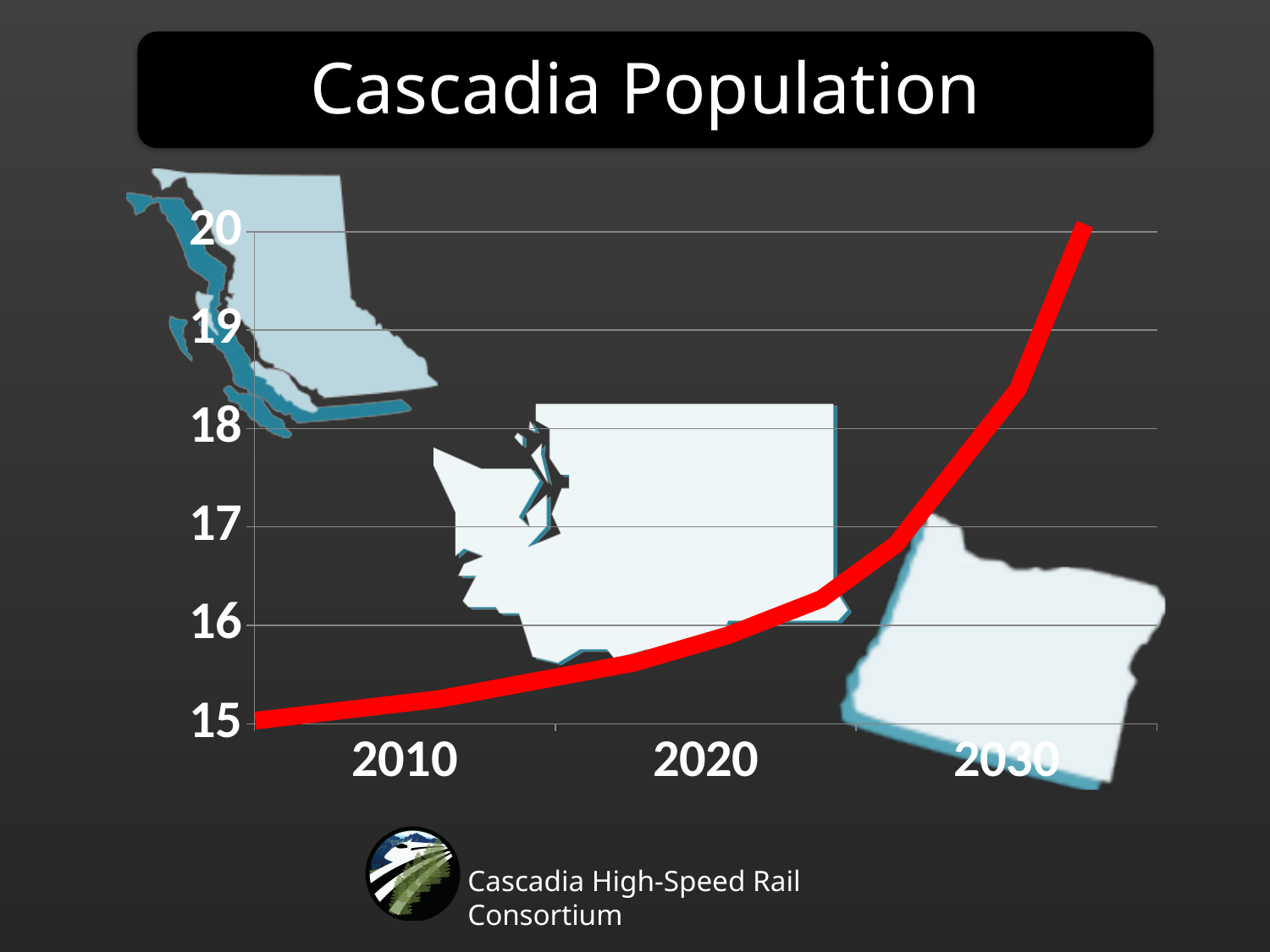
Which year shown on the x axis has the higher value, 2010 or 2030? 2030 What kind of chart is shown on the slide? line chart Is the value for 2030 greater or less than 17? greater Does the plotted line rise or fall as the years increase along the x axis? rise Which of the labelled years, 2010, 2020 or 2030, has the lowest value on the line? 2010 How many year labels are shown on the x axis? 3 Is the value for 2020 greater or less than 17? less What is the lowest value labelled on the y axis? 15 What is the title of the chart? Cascadia Population Is the value for 2030 greater or less than 19? less What colour is the plotted line? red